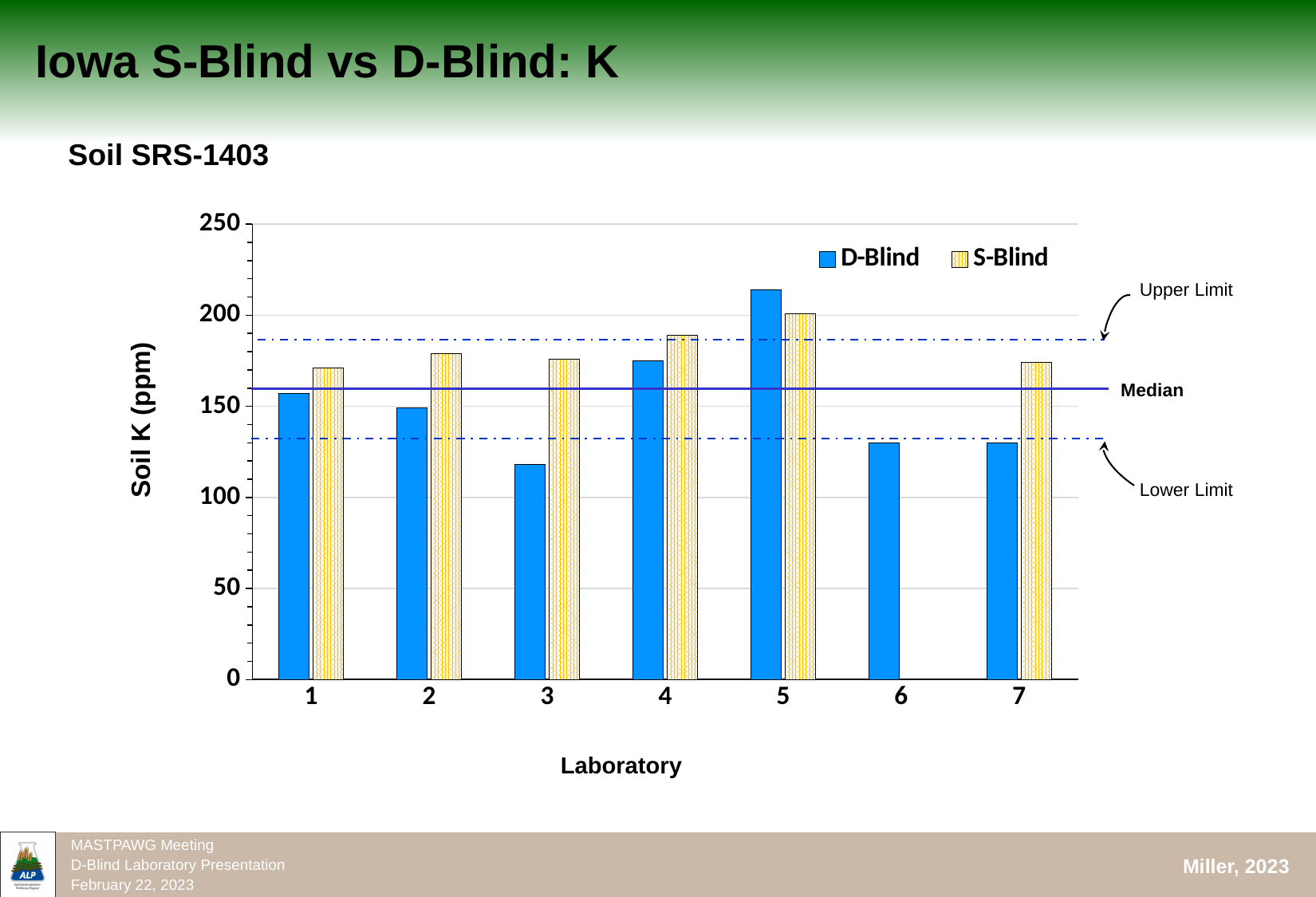
How many laboratories are shown on the x axis? 7 What kind of chart is shown on the slide? bar chart How many series does the legend list? 2 Is the S-Blind value for laboratory 2 greater or less than 150? greater Which laboratory has no S-Blind bar? 6 For laboratory 3, which is larger, the D-Blind value or the S-Blind value? S-Blind Is the D-Blind value for laboratory 5 greater or less than 200? greater What is the label of the y axis? Soil K (ppm) Which laboratory has the highest S-Blind value? 5 Is the D-Blind value for laboratory 3 greater or less than 150? less Which laboratory has the lowest D-Blind value? 3 Which laboratory has the highest D-Blind value? 5